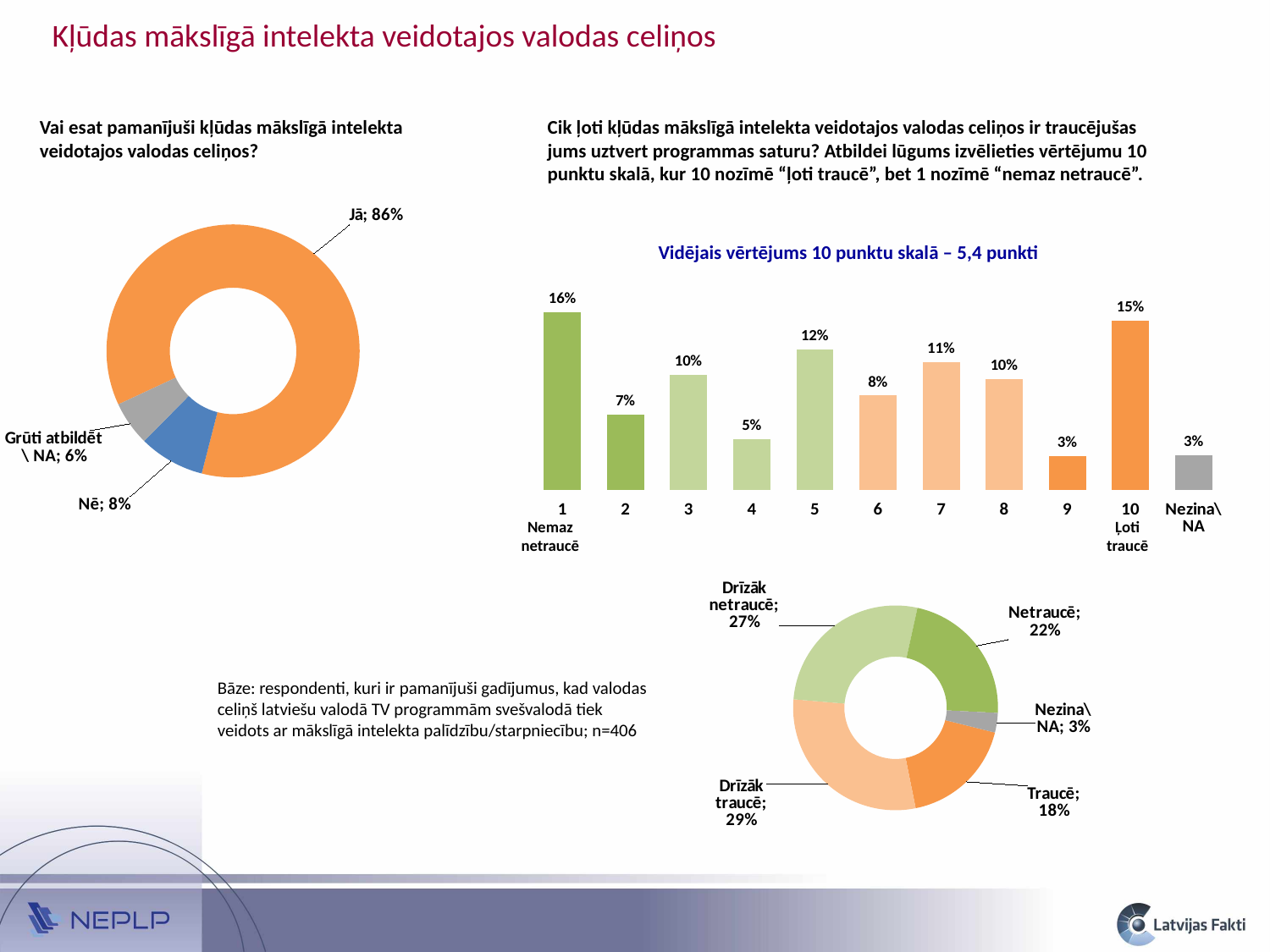
In the donut chart at the bottom right, what share of respondents answered "Drīzāk traucē"? 29% In the bar chart on the right, what is the difference between the percentages for rating 5 and rating 4? 7% In the donut chart on the left, which category has the smallest share? Grūti atbildēt \ NA In the donut chart on the left, how many categories are shown? 3 In the donut chart at the bottom right, what is the combined share of "Traucē" and "Drīzāk traucē"? 47% In the bar chart on the right, how many bars are shown? 11 In the donut chart on the left, what share of respondents answered "Nē"? 8% In the donut chart on the left, what share of respondents answered "Jā"? 86% In the bar chart on the right, which is larger: the value for rating 7 or the value for rating 6? Rating 7 In the bar chart on the right, what percentage of respondents chose rating 10 (Ļoti traucē)? 15% In the bar chart on the right, which rating has the highest percentage? 1 In the bar chart on the right, what percentage of respondents chose rating 1 (Nemaz netraucē)? 16%